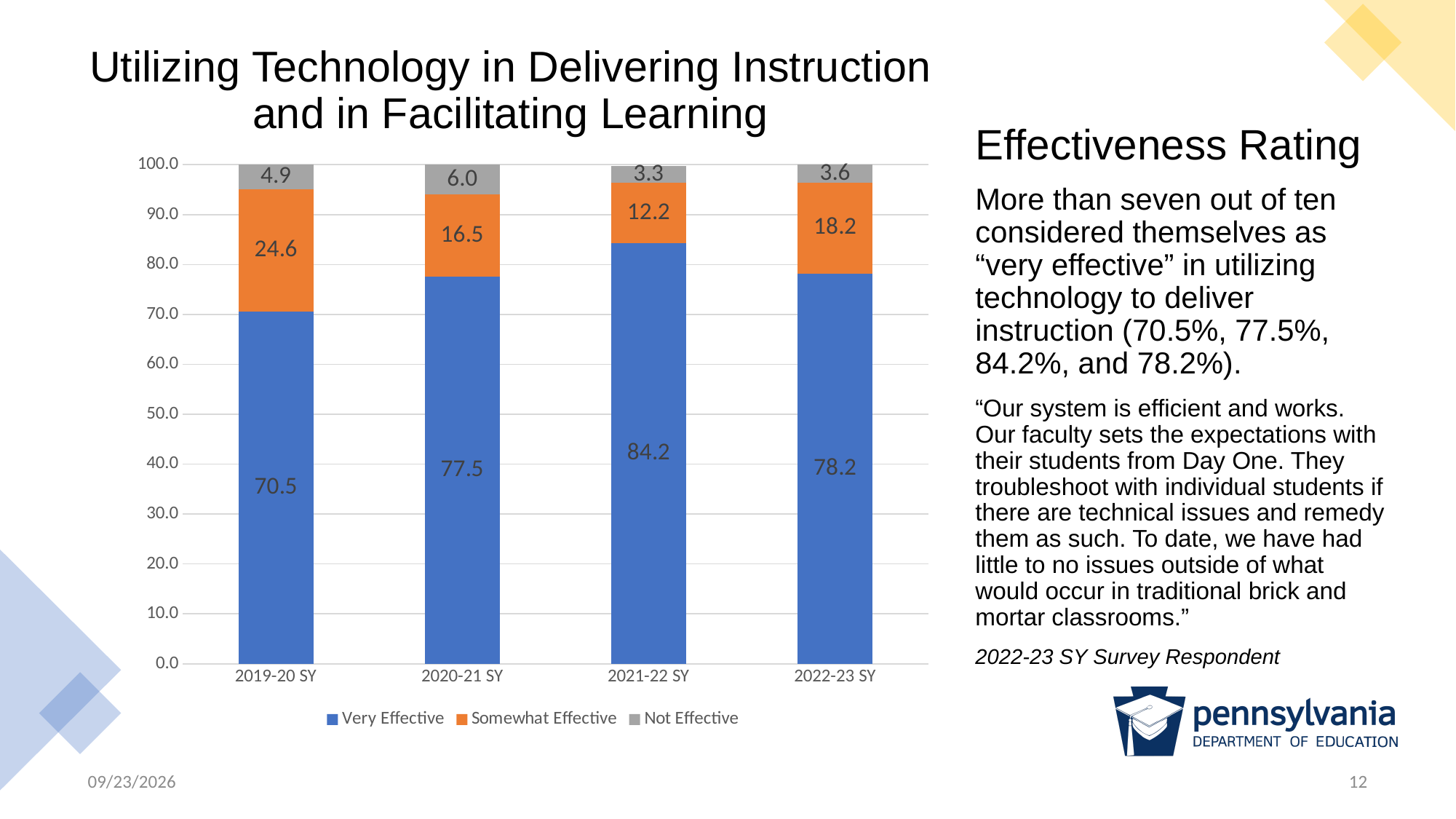
Which school year has the highest Very Effective value? 2021-22 SY Which school year has the lowest Somewhat Effective value? 2021-22 SY What kind of chart is shown on the slide? Stacked bar chart What is the Not Effective value for 2020-21 SY? 6.0 How many school years are shown on the x axis? 4 What is the Very Effective value for 2021-22 SY? 84.2 What is the total of the stacked bar for 2021-22 SY? 99.7 Does the Very Effective value rise or fall from 2019-20 SY to 2021-22 SY? Rise What is the Somewhat Effective value for 2022-23 SY? 18.2 What is the difference between the Somewhat Effective values for 2019-20 SY and 2022-23 SY? 6.4 How many series does the legend list? 3 Which has the larger Very Effective value, 2020-21 SY or 2022-23 SY? 2022-23 SY